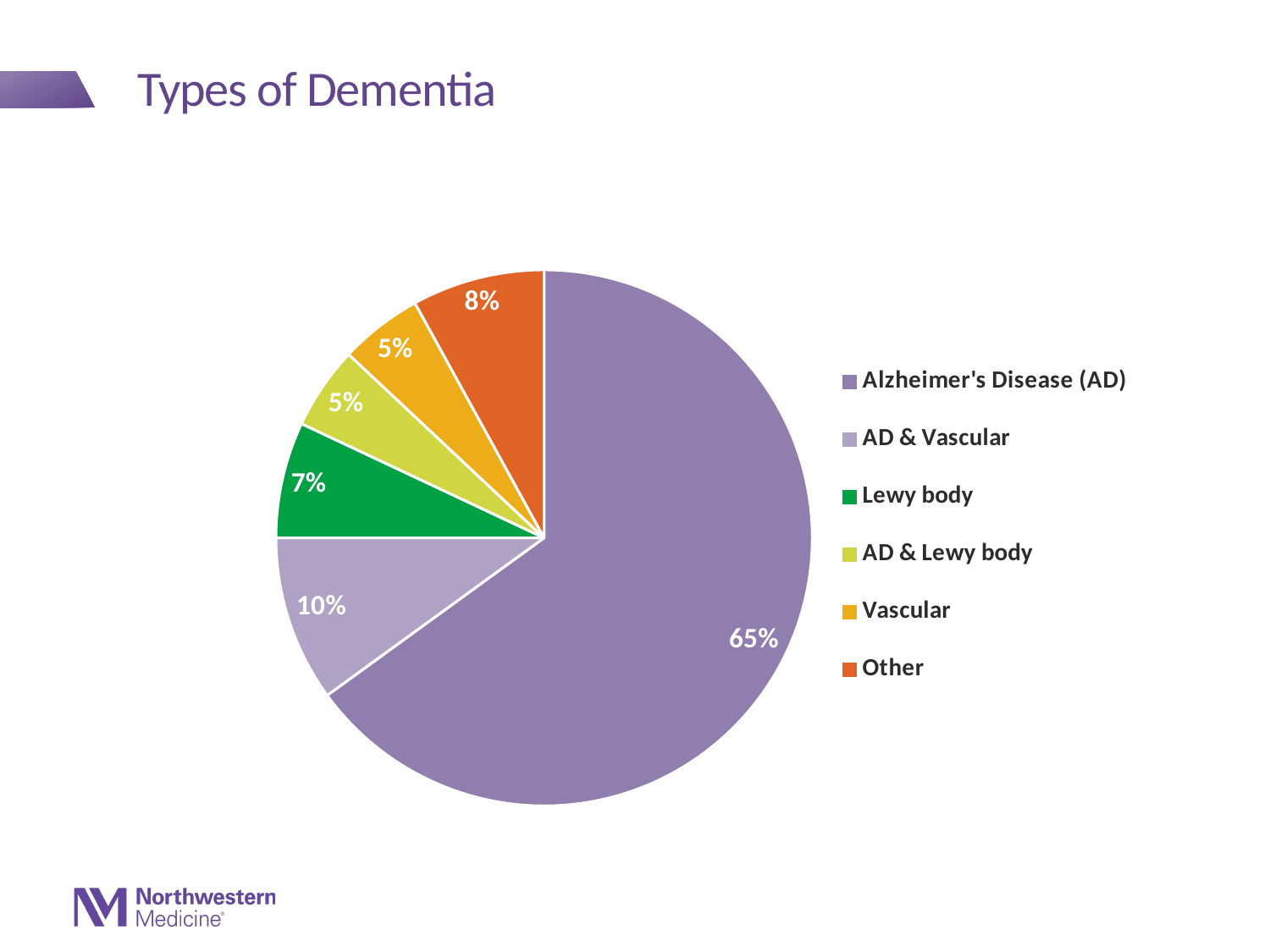
What is the value for AD & Vascular? 10% What colour is the slice for Lewy body? green Which category has the largest slice of the pie? Alzheimer's Disease (AD) What share of the pie does Alzheimer's Disease (AD) account for? 65% How many categories does the legend list? 6 What is the value for Lewy body? 7% What is the difference between the Alzheimer's Disease (AD) share and the AD & Vascular share? 55% What is the title of the slide containing the chart? Types of Dementia What type of chart is shown on the slide? pie chart Which is larger, the share for Other or the share for Lewy body? Other What is the difference between the Other share and the Lewy body share? 1% What is the value for Other? 8%